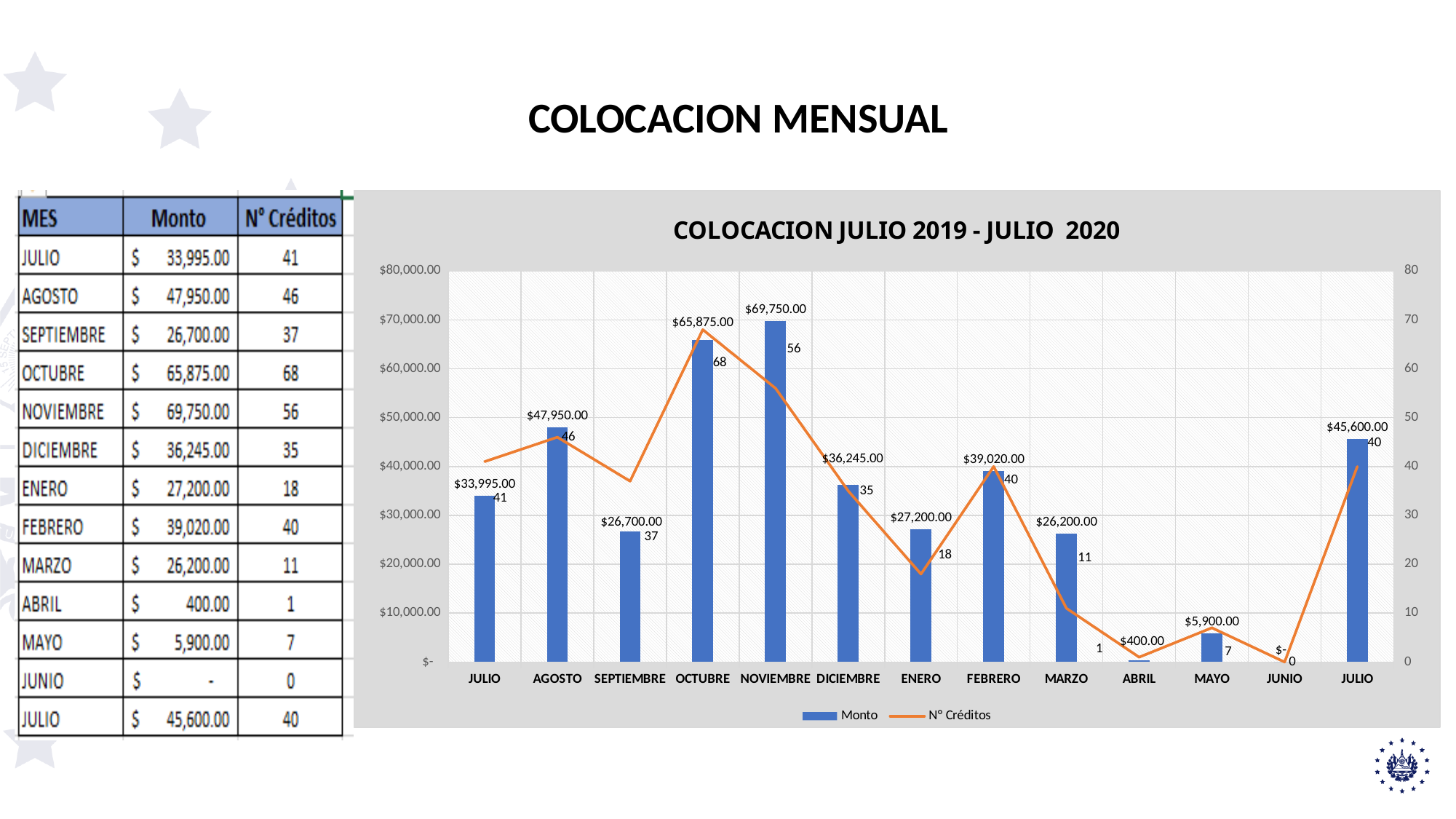
Which month has the highest Monto? NOVIEMBRE What is the N° Créditos value for MAYO? 7 How many series does the chart legend list? 2 What is the Monto value for the last JULIO on the x axis? $45,600.00 Which month has the lowest N° Créditos? JUNIO What is the title of the chart? COLOCACION JULIO 2019 - JULIO 2020 Which has a larger Monto, AGOSTO or DICIEMBRE? AGOSTO What is the difference in Monto between NOVIEMBRE and OCTUBRE? $3,875.00 What is the difference in N° Créditos between OCTUBRE and NOVIEMBRE? 12 How many months are shown on the x axis of the chart? 13 What is the Monto value for OCTUBRE? $65,875.00 What is the N° Créditos value for ENERO? 18